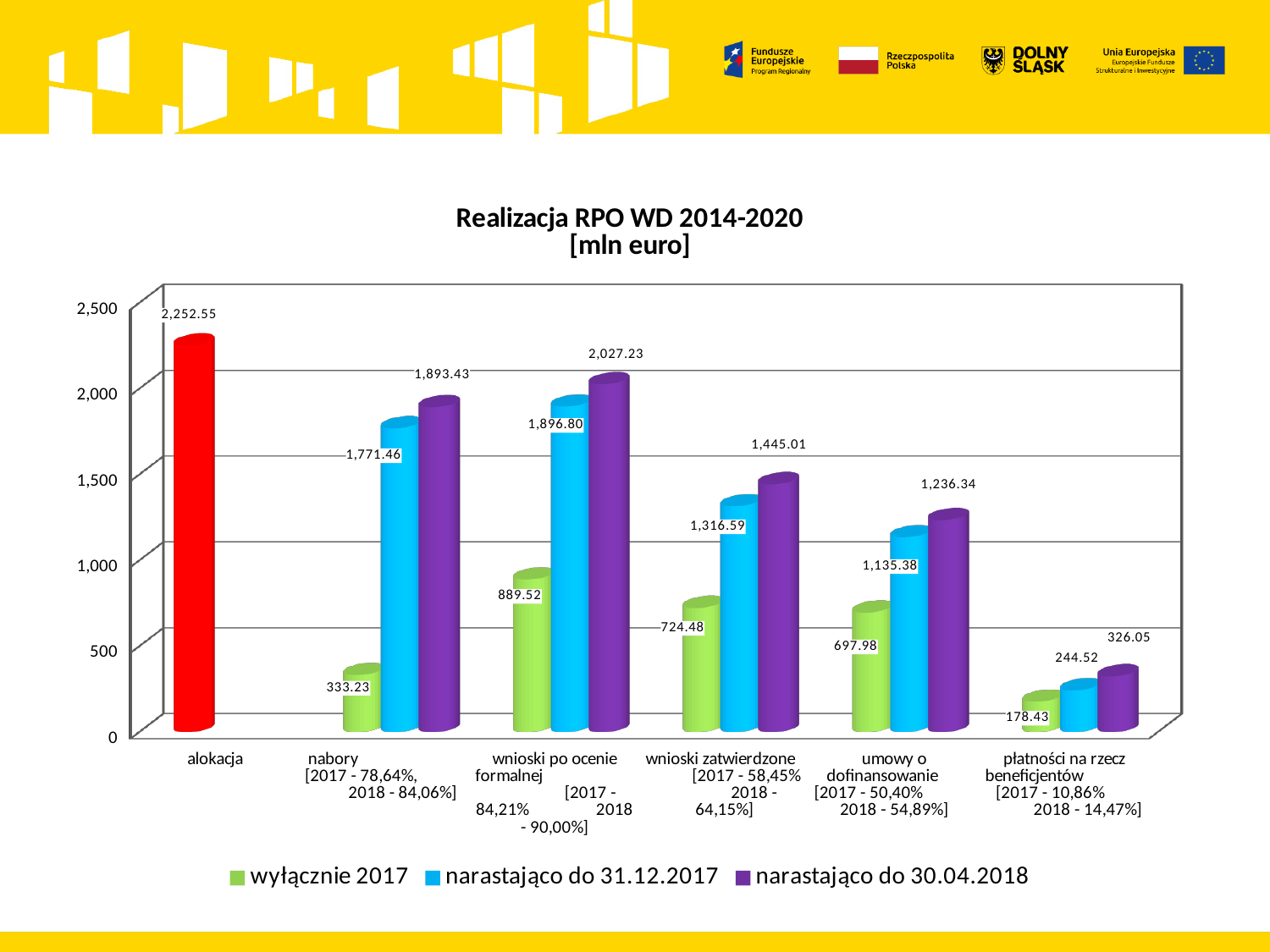
What is the value of the 'wyłącznie 2017' bar for 'nabory'? 333.23 What is the value of the 'narastająco do 31.12.2017' bar for 'umowy o dofinansowanie'? 1,135.38 Which category has the lowest 'narastająco do 30.04.2018' value? płatności na rzecz beneficjentów What is the difference between the 'narastająco do 30.04.2018' and 'narastająco do 31.12.2017' values for 'wnioski zatwierdzone'? 128.42 Is the 'narastająco do 30.04.2018' value for 'umowy o dofinansowanie' greater or less than 1,000? greater How many series does the legend list? 3 Which is larger: the 'narastająco do 31.12.2017' value for 'nabory' or for 'wnioski zatwierdzone'? nabory What type of chart is shown on the slide? bar chart Which category has the highest 'wyłącznie 2017' value? wnioski po ocenie formalnej What is the value of the 'narastająco do 30.04.2018' bar for 'wnioski po ocenie formalnej'? 2,027.23 What unit is given in the chart title? mln euro What is the value shown for 'alokacja'? 2,252.55